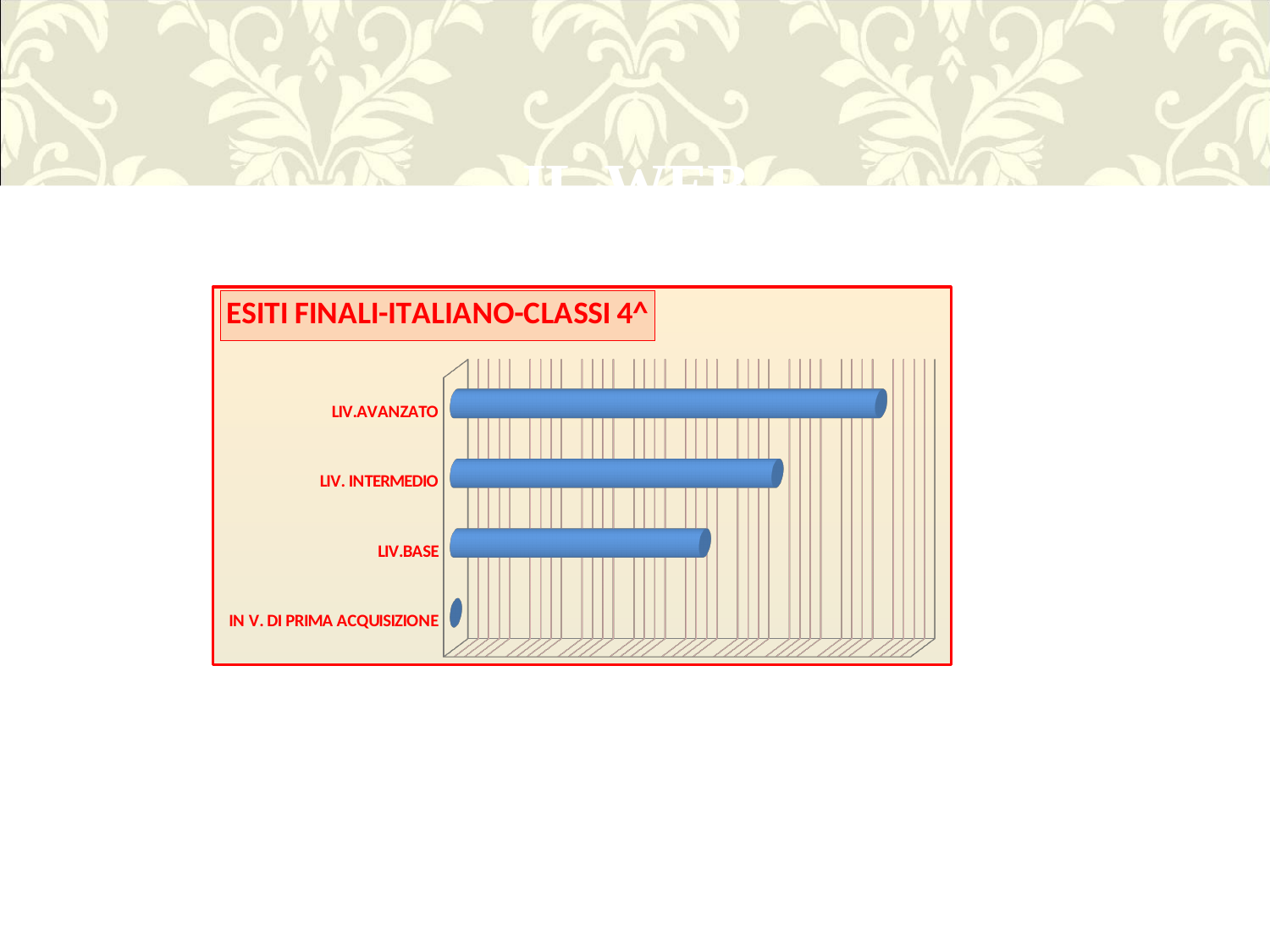
What kind of chart is shown on the slide? Bar chart Which is larger, the value for LIV. INTERMEDIO or the value for LIV.BASE? LIV. INTERMEDIO How many categories are plotted in the chart? 4 Which is larger, the value for LIV.BASE or the value for IN V. DI PRIMA ACQUISIZIONE? LIV.BASE What is the title of the chart? ESITI FINALI-ITALIANO-CLASSI 4^ Do the bar values rise or fall going from the top category (LIV.AVANZATO) down to the bottom category (IN V. DI PRIMA ACQUISIZIONE)? Fall Which category has the highest value in the chart? LIV.AVANZATO What colour are the bars in the chart? Blue Which is larger, the value for LIV.AVANZATO or the value for LIV. INTERMEDIO? LIV.AVANZATO Which category has the lowest value in the chart? IN V. DI PRIMA ACQUISIZIONE